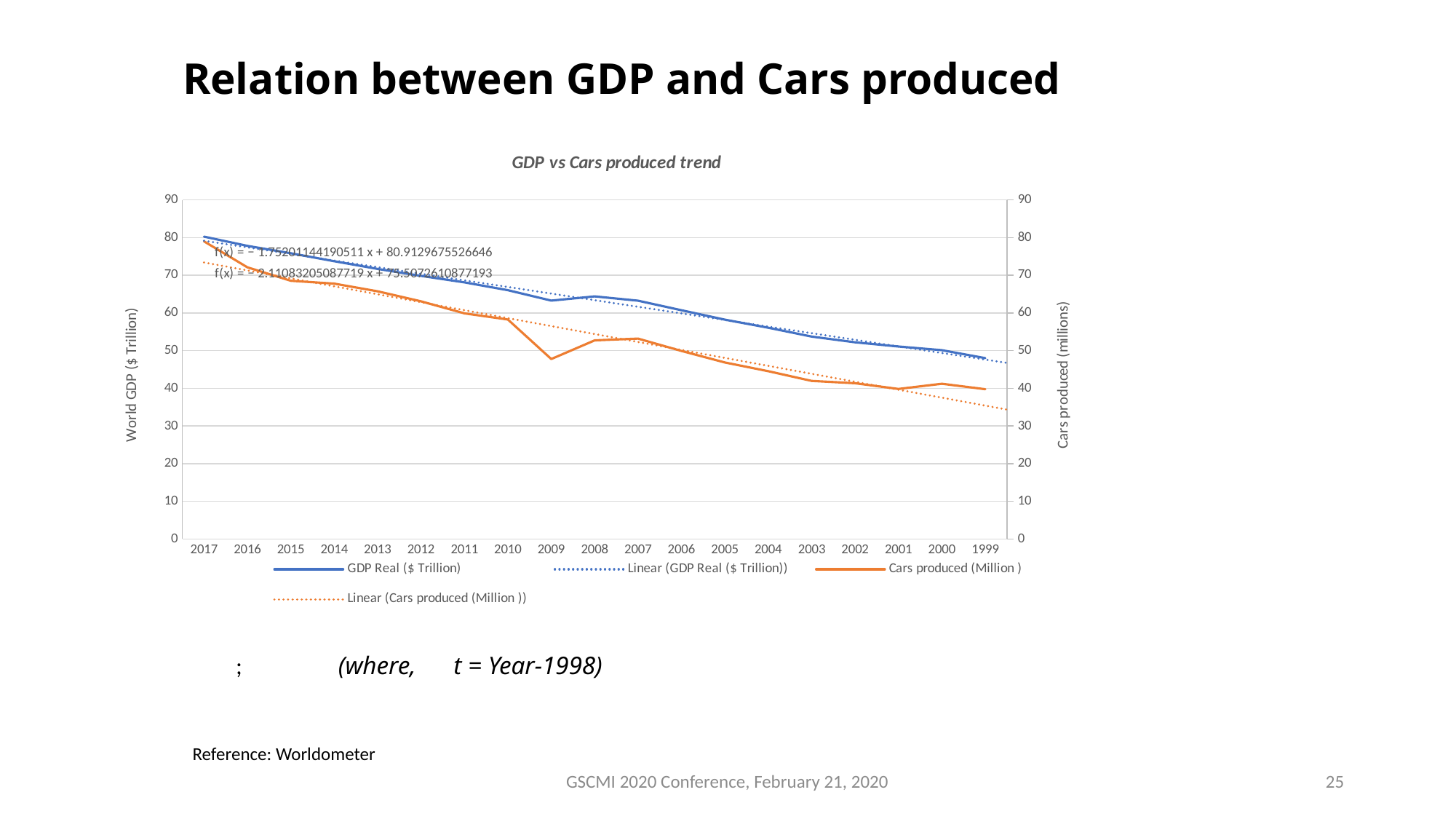
How many entries does the chart legend list? 4 Is the Cars produced (Million) value for 2009 greater or less than 50? less Does the GDP Real ($ Trillion) line rise or fall moving left to right along the x axis from 2017 to 1999? fall Is the Cars produced (Million) value for 1999 greater or less than 50? less In 2009, which is larger: the GDP Real ($ Trillion) value or the Cars produced (Million) value? GDP Real ($ Trillion) What is the title of the chart? GDP vs Cars produced trend What kind of chart is shown on the slide? line chart Is the GDP Real ($ Trillion) value for 2009 greater or less than 60? greater How many years are shown on the x axis of the chart? 19 What is the label of the left vertical axis of the chart? World GDP ($ Trillion) In which year is the GDP Real ($ Trillion) value highest? 2017